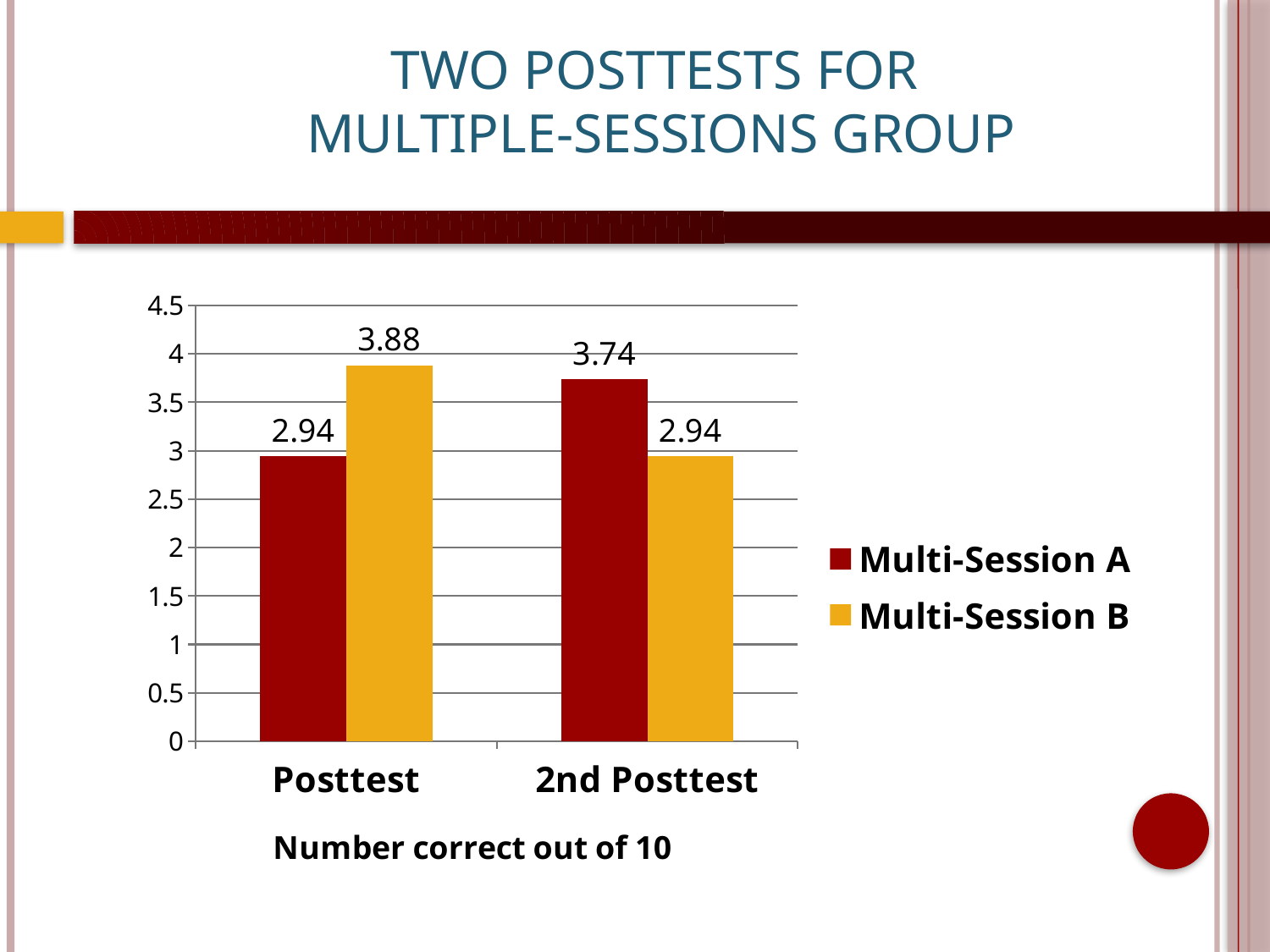
Which series has the lowest value at 2nd Posttest? Multi-Session B What is the difference between Multi-Session A and Multi-Session B at 2nd Posttest? 0.8 How many series does the legend list? 2 Which series has the highest value at Posttest? Multi-Session B What is the value for Multi-Session B at Posttest? 3.88 How many categories are shown on the x axis? 2 What is the value for Multi-Session B at 2nd Posttest? 2.94 What is the value for Multi-Session A at Posttest? 2.94 What is the difference between Multi-Session B and Multi-Session A at Posttest? 0.94 Which is larger: Multi-Session A at 2nd Posttest or Multi-Session B at Posttest? Multi-Session B at Posttest What kind of chart is shown on the slide? Bar chart What is the value for Multi-Session A at 2nd Posttest? 3.74